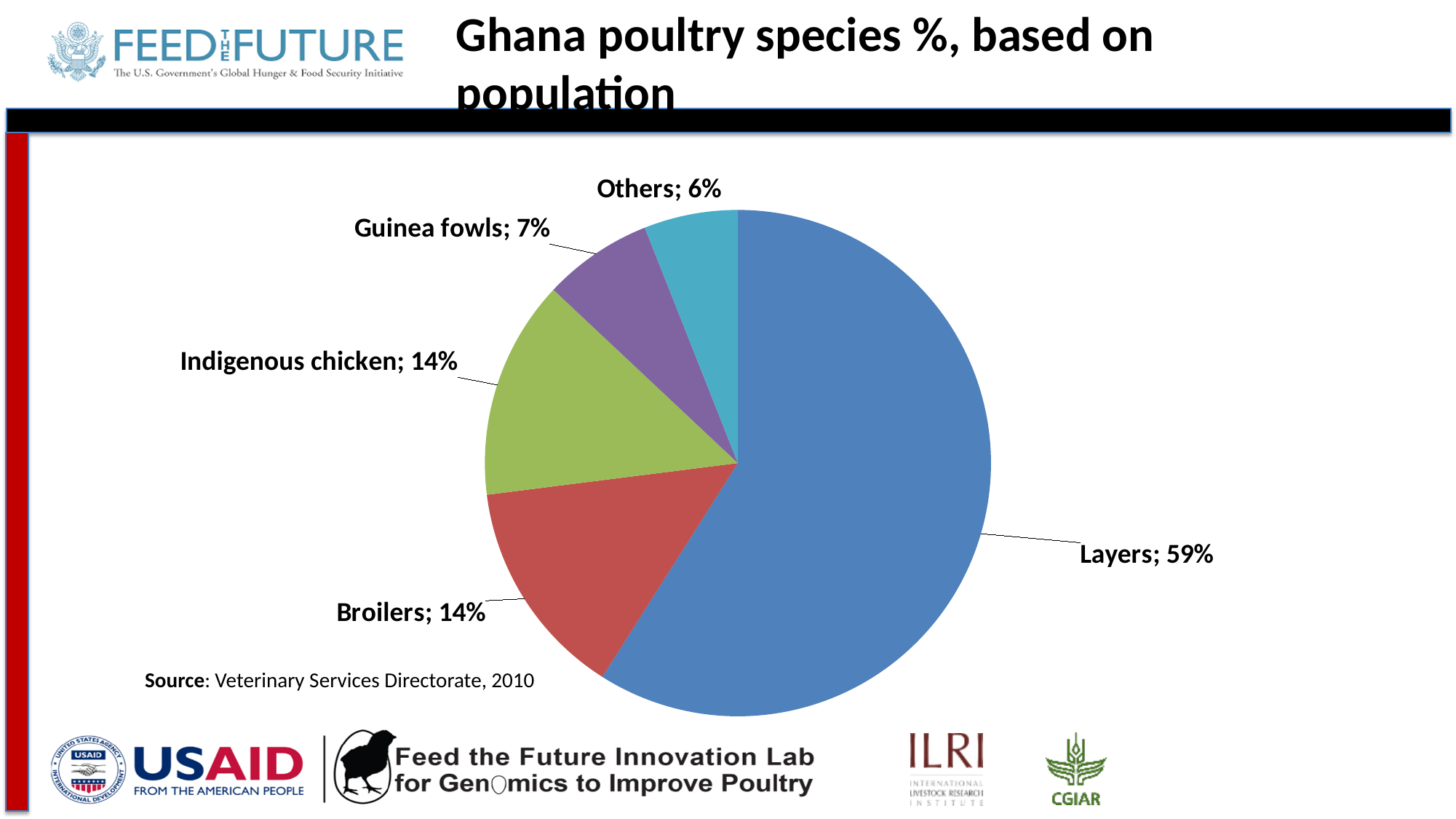
Which is larger, the share for Guinea fowls or the share for Others? Guinea fowls What percentage of Ghana's poultry population is Indigenous chicken? 14% How many slices does the pie chart have? 5 What is the difference in percentage points between Layers and Broilers? 45 What is the combined share of Broilers and Indigenous chicken? 28% Which poultry species has the largest share of the pie? Layers What source is cited for the chart data? Veterinary Services Directorate, 2010 What percentage of Ghana's poultry population is Others? 6% What percentage of Ghana's poultry population is Guinea fowls? 7% What percentage of Ghana's poultry population is Layers? 59% Which poultry species has the smallest share of the pie? Others What type of chart is shown on the slide? Pie chart